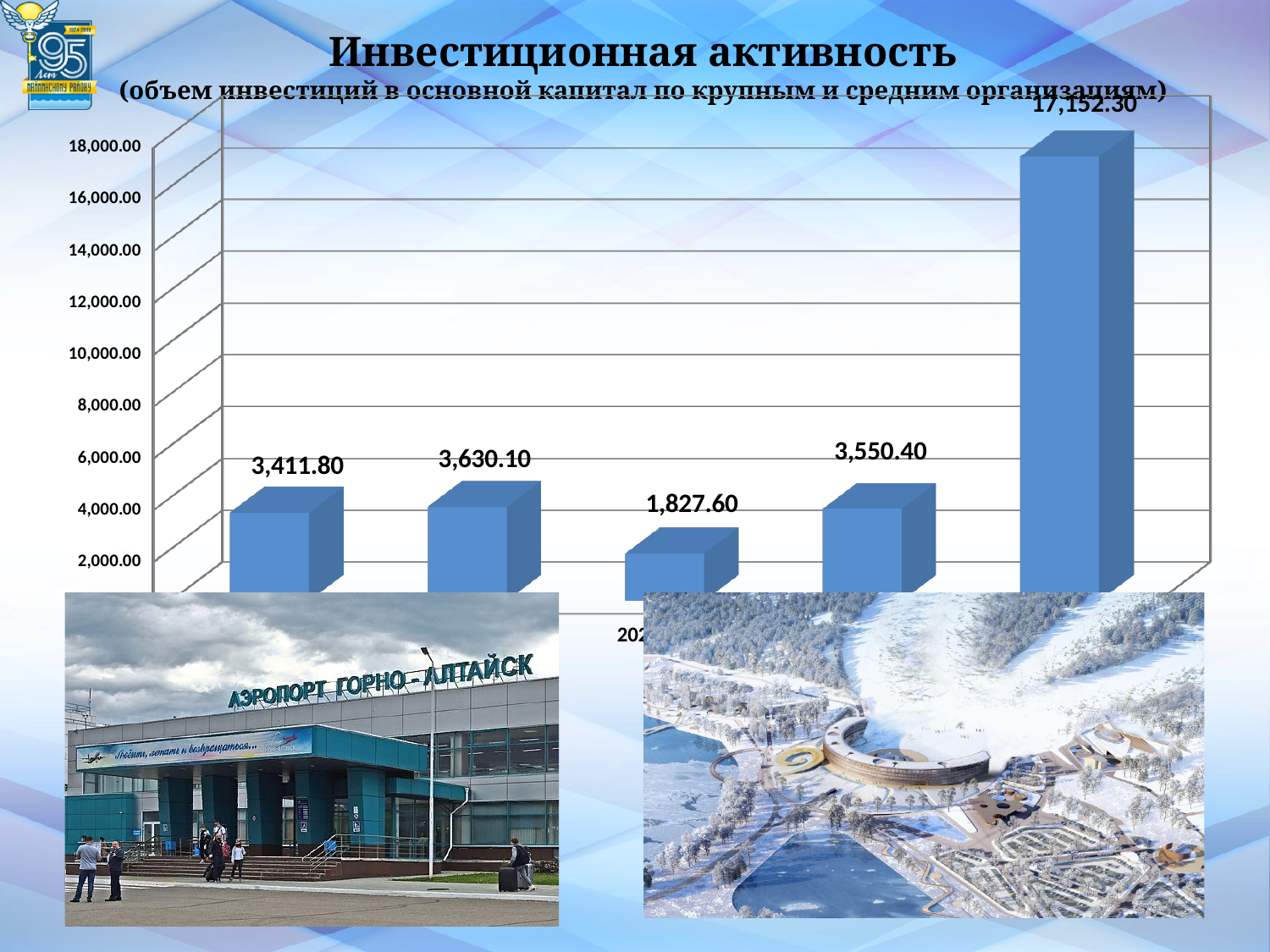
Which bar has the lowest value? The middle (third) bar, 1,827.60 Which bar has the highest value? The rightmost (fifth) bar, 17,152.30 Which is larger: the second bar (3,630.10) or the fourth bar (3,550.40)? The second bar, 3,630.10 What is the value shown on the first (leftmost) bar of the chart? 3,411.80 What is the value shown on the last (rightmost) bar? 17,152.30 What is the value shown on the middle (third) bar? 1,827.60 What is the value shown on the fourth bar from the left? 3,550.40 What is the value shown on the second bar from the left? 3,630.10 What is the difference between the rightmost bar (17,152.30) and the leftmost bar (3,411.80)? 13,740.50 What is the main title of the chart on the slide? Инвестиционная активность How many bars are plotted in the chart? 5 What type of chart is shown on the slide? Bar chart